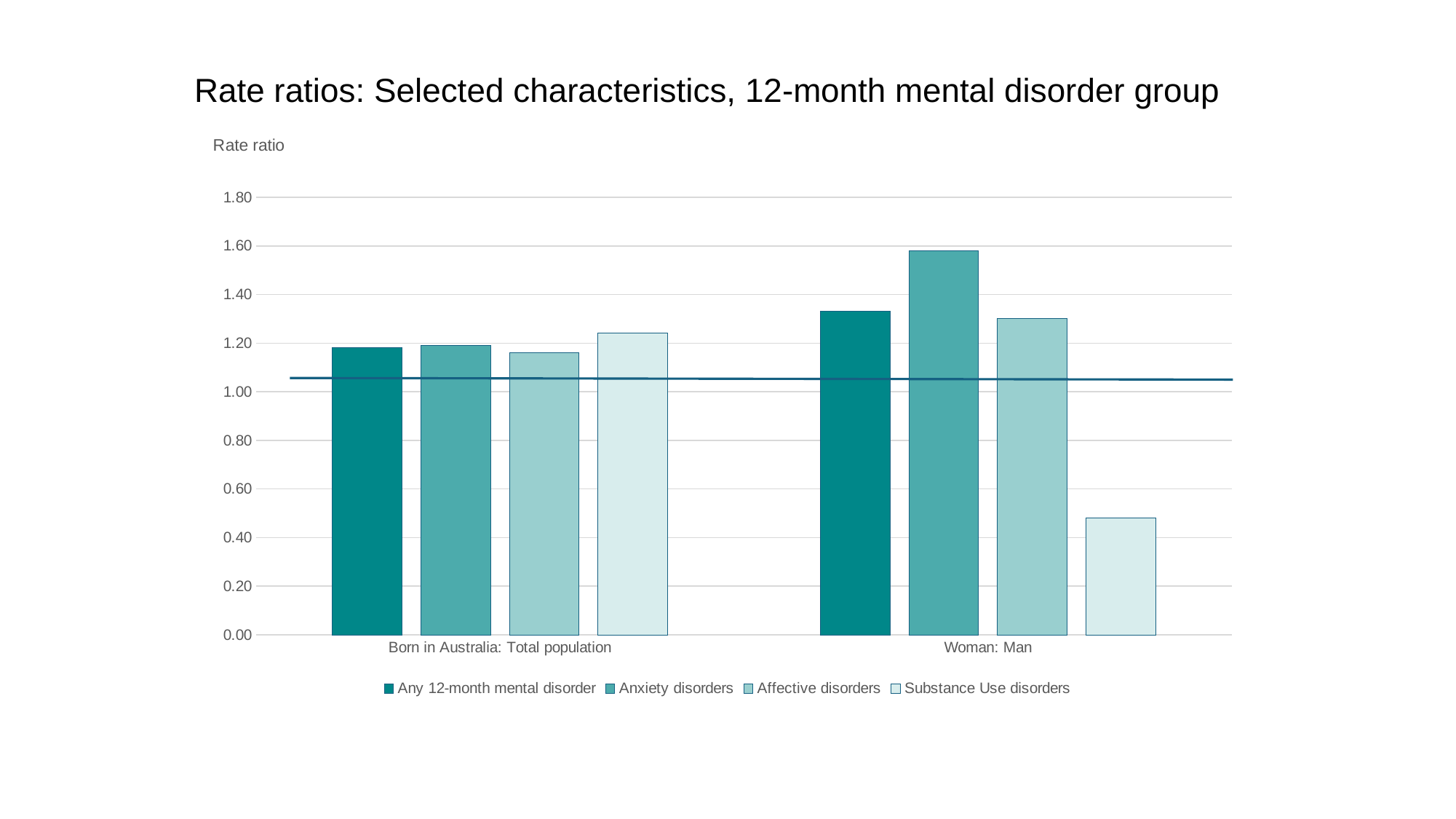
Which is larger: Substance Use disorders for Born in Australia: Total population or Substance Use disorders for Woman: Man? Born in Australia: Total population What kind of chart is shown on the slide? bar chart What is the label on the vertical axis? Rate ratio How many categories are shown on the x axis? 2 Is the value for Affective disorders in the Woman: Man group greater or less than 1.20? greater Is the value for Substance Use disorders in the Woman: Man group greater or less than 0.60? less In the Woman: Man group, which series has the highest bar? Anxiety disorders Is the value for Anxiety disorders in the Woman: Man group greater or less than 1.40? greater What is the title of the chart? Rate ratios: Selected characteristics, 12-month mental disorder group How many series does the legend list? 4 Which is larger: Anxiety disorders for Born in Australia: Total population or Anxiety disorders for Woman: Man? Woman: Man In the Woman: Man group, which series has the lowest bar? Substance Use disorders